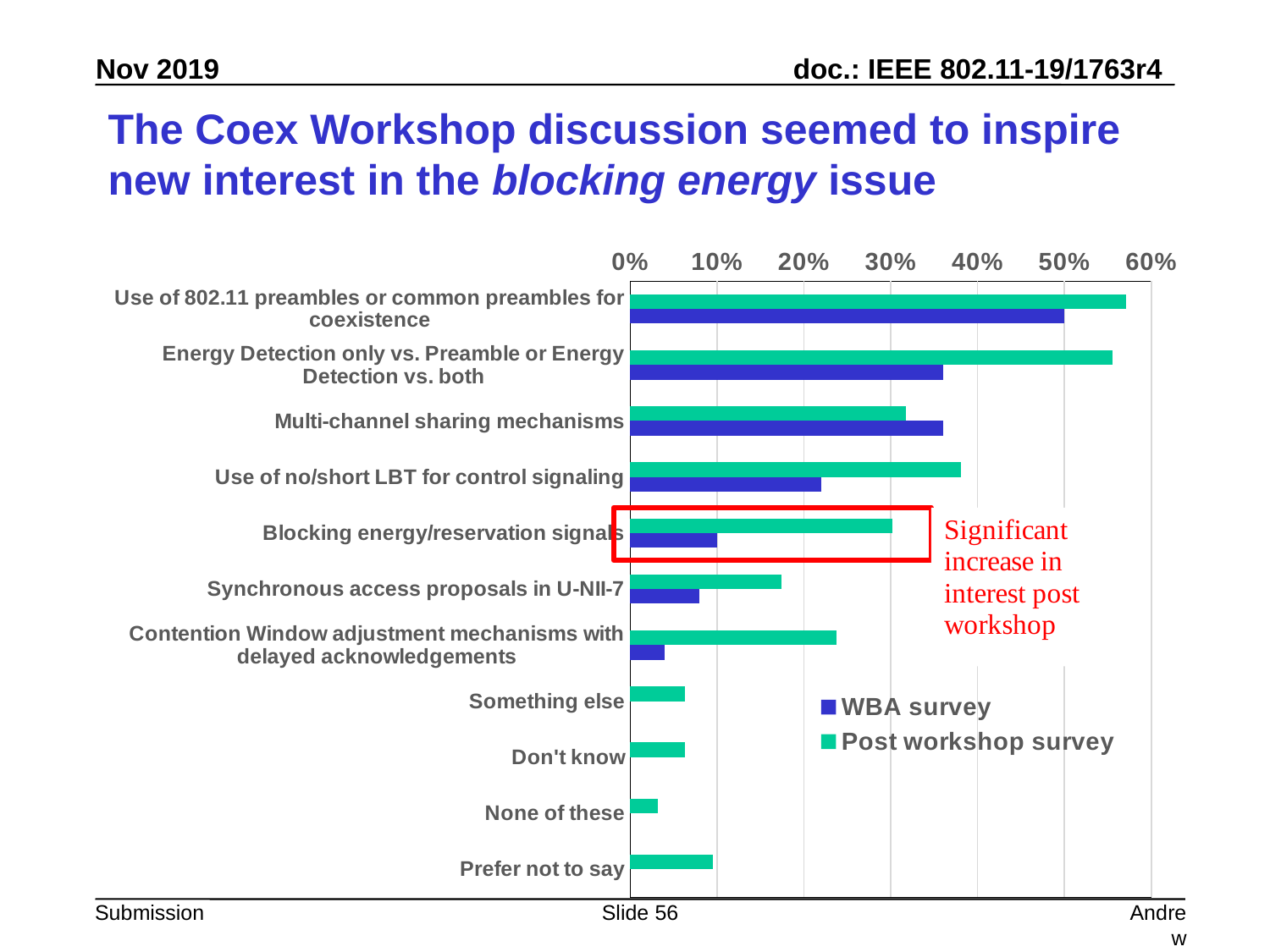
Which category has the highest value in the Post workshop survey series? Use of 802.11 preambles or common preambles for coexistence Which colour represents the Post workshop survey series? green What kind of chart is shown on the slide? bar chart Which category has the lowest value in the Post workshop survey series? None of these Is the Post workshop survey value for Use of no/short LBT for control signaling greater or less than 30%? greater How many categories are shown on the chart? 11 How many series does the legend list? 2 For Multi-channel sharing mechanisms, which series has the larger value, WBA survey or Post workshop survey? WBA survey Is the Post workshop survey value for Energy Detection only vs. Preamble or Energy Detection vs. both greater or less than 50%? greater Is the WBA survey value for Blocking energy/reservation signals greater or less than 20%? less For Contention Window adjustment mechanisms with delayed acknowledgements, which series has the larger value, WBA survey or Post workshop survey? Post workshop survey Which category has the highest value in the WBA survey series? Use of 802.11 preambles or common preambles for coexistence